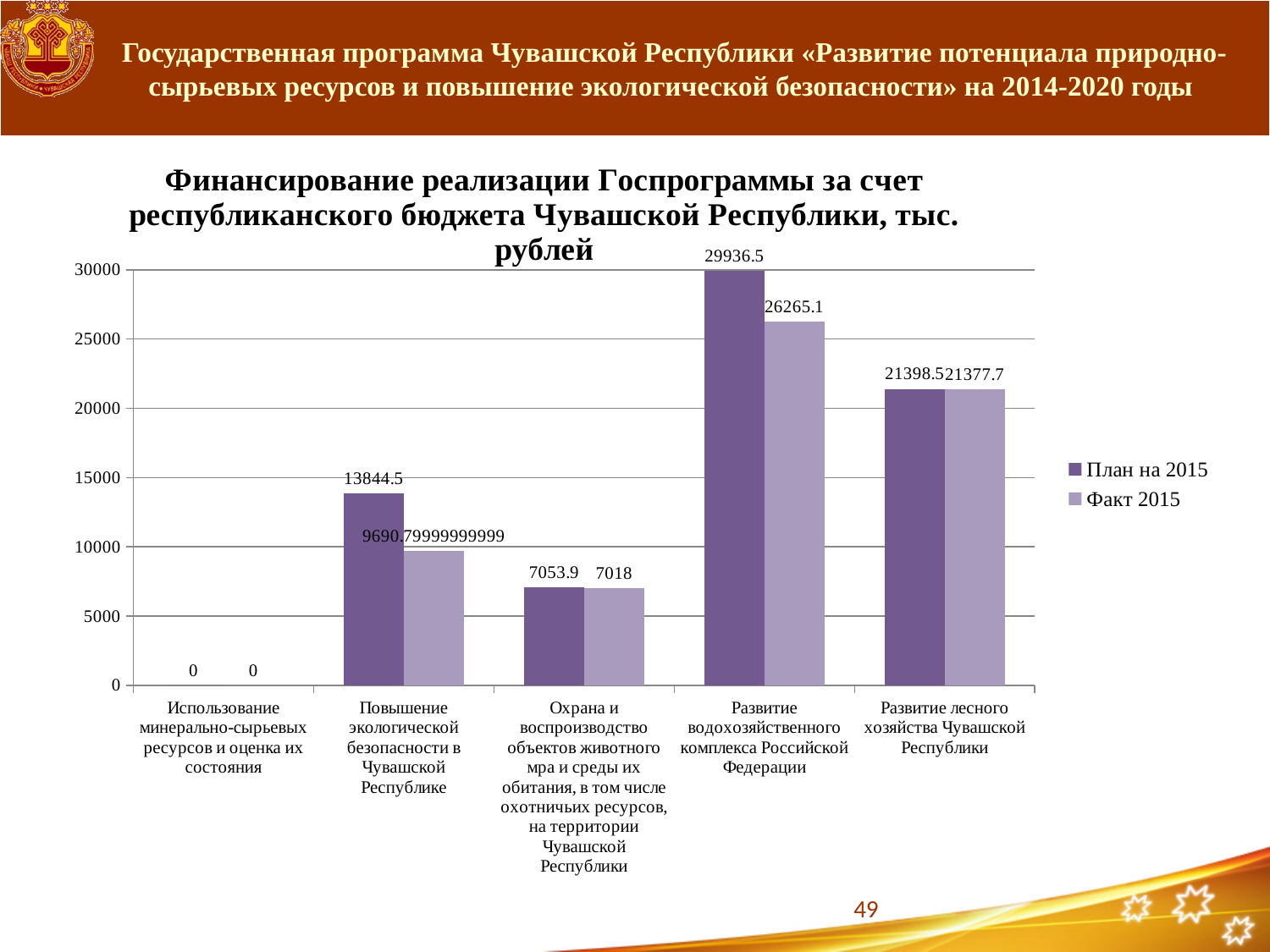
What is the value of "План на 2015" for "Повышение экологической безопасности в Чувашской Республике"? 13844.5 Is the value of "Факт 2015" for "Повышение экологической безопасности в Чувашской Республике" greater or less than 5000? greater What is the difference between "План на 2015" and "Факт 2015" for "Развитие водохозяйственного комплекса Российской Федерации"? 3671.4 What is the value of "Факт 2015" for "Охрана и воспроизводство объектов животного мира и среды их обитания, в том числе охотничьих ресурсов, на территории Чувашской Республики"? 7018 How many categories are shown on the x axis? 5 Which category has the lowest value for "Факт 2015"? Использование минерально-сырьевых ресурсов и оценка их состояния What is the value of "Факт 2015" for "Развитие водохозяйственного комплекса Российской Федерации"? 26265.1 For "Развитие водохозяйственного комплекса Российской Федерации", which is larger: "План на 2015" or "Факт 2015"? План на 2015 Which category has the highest value for "План на 2015"? Развитие водохозяйственного комплекса Российской Федерации How many series does the legend list? 2 What is the value of "План на 2015" for "Развитие водохозяйственного комплекса Российской Федерации"? 29936.5 What type of chart is shown on the slide? bar chart